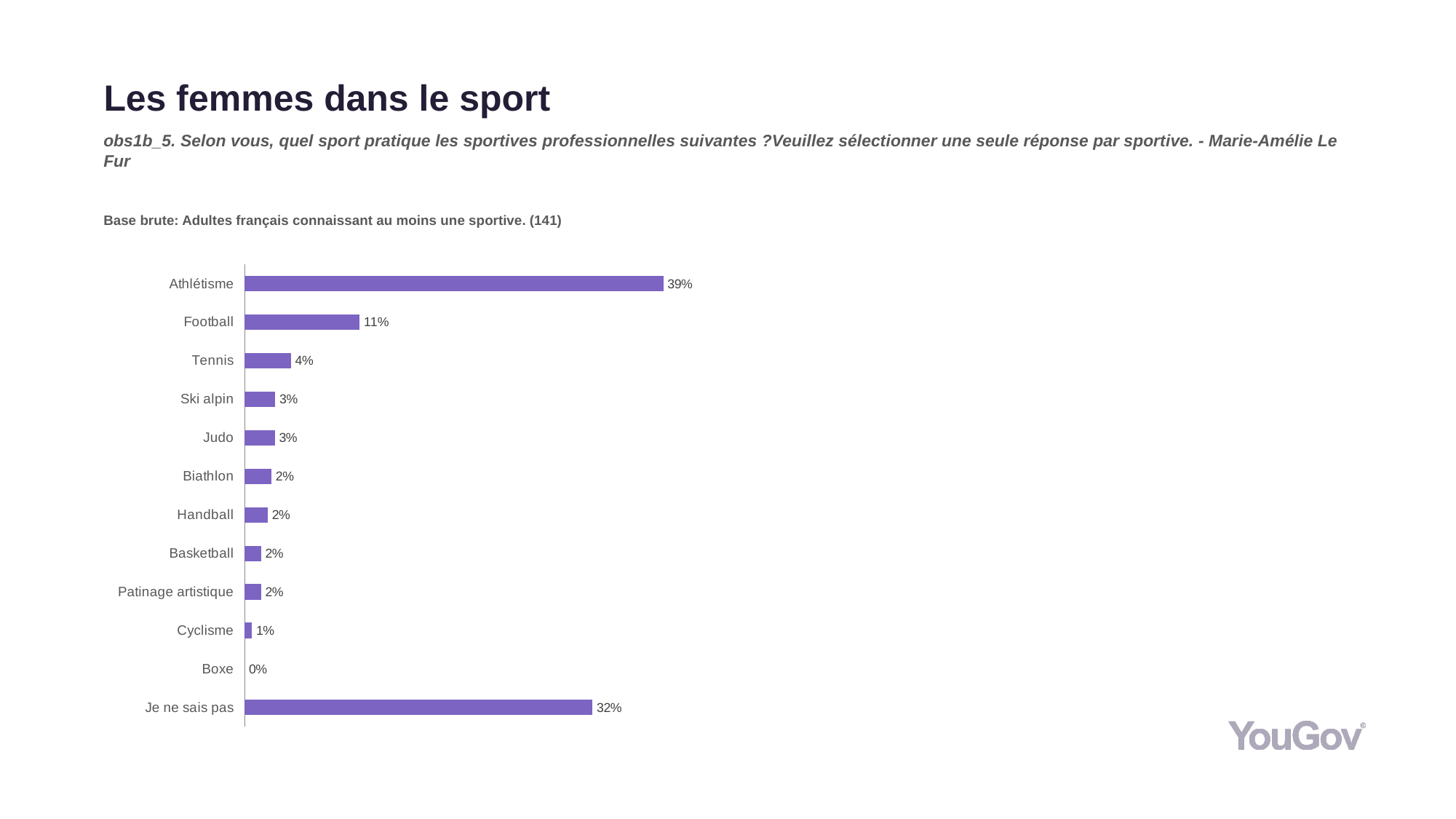
What is the value for Football? 11% How many categories are shown in the chart? 12 What is the value for Je ne sais pas? 32% What is the value for Tennis? 4% Which category has the lowest value? Boxe What is the value for Boxe? 0% What is the difference between the values for Football and Tennis? 7% What is the difference between the values for Athlétisme and Je ne sais pas? 7% Which is larger, the value for Football or the value for Cyclisme? Football What kind of chart is shown on the slide? Bar chart Which category has the highest value? Athlétisme What is the value for Athlétisme? 39%